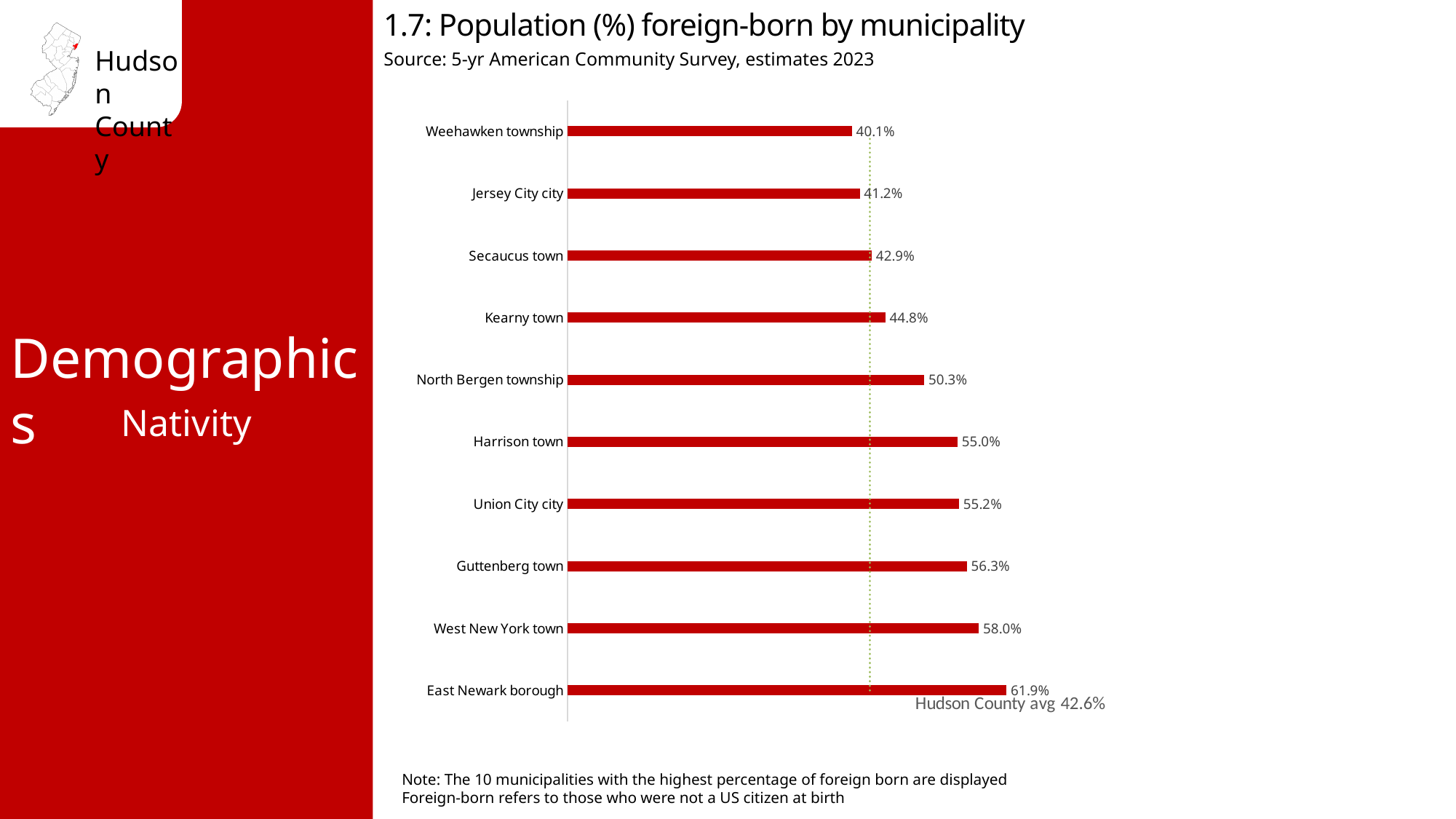
What is the source of the data shown in the chart? 5-yr American Community Survey, estimates 2023 Which has a higher foreign-born percentage, Harrison town or Secaucus town? Harrison town Which municipality has the lowest percentage of foreign-born population shown on the chart? Weehawken township What is the Hudson County average foreign-born percentage indicated by the dotted line? 42.6% What is the foreign-born population percentage for Jersey City city? 41.2% What is the difference in foreign-born percentage between Guttenberg town and Kearny town? 11.5% Which municipality has the highest percentage of foreign-born population? East Newark borough What type of chart is used to show the foreign-born population by municipality? Bar chart What is the difference in foreign-born percentage between East Newark borough and Weehawken township? 21.8% What is the foreign-born population percentage for North Bergen township? 50.3% What is the foreign-born population percentage for West New York town? 58.0% How many municipalities are shown on the chart? 10